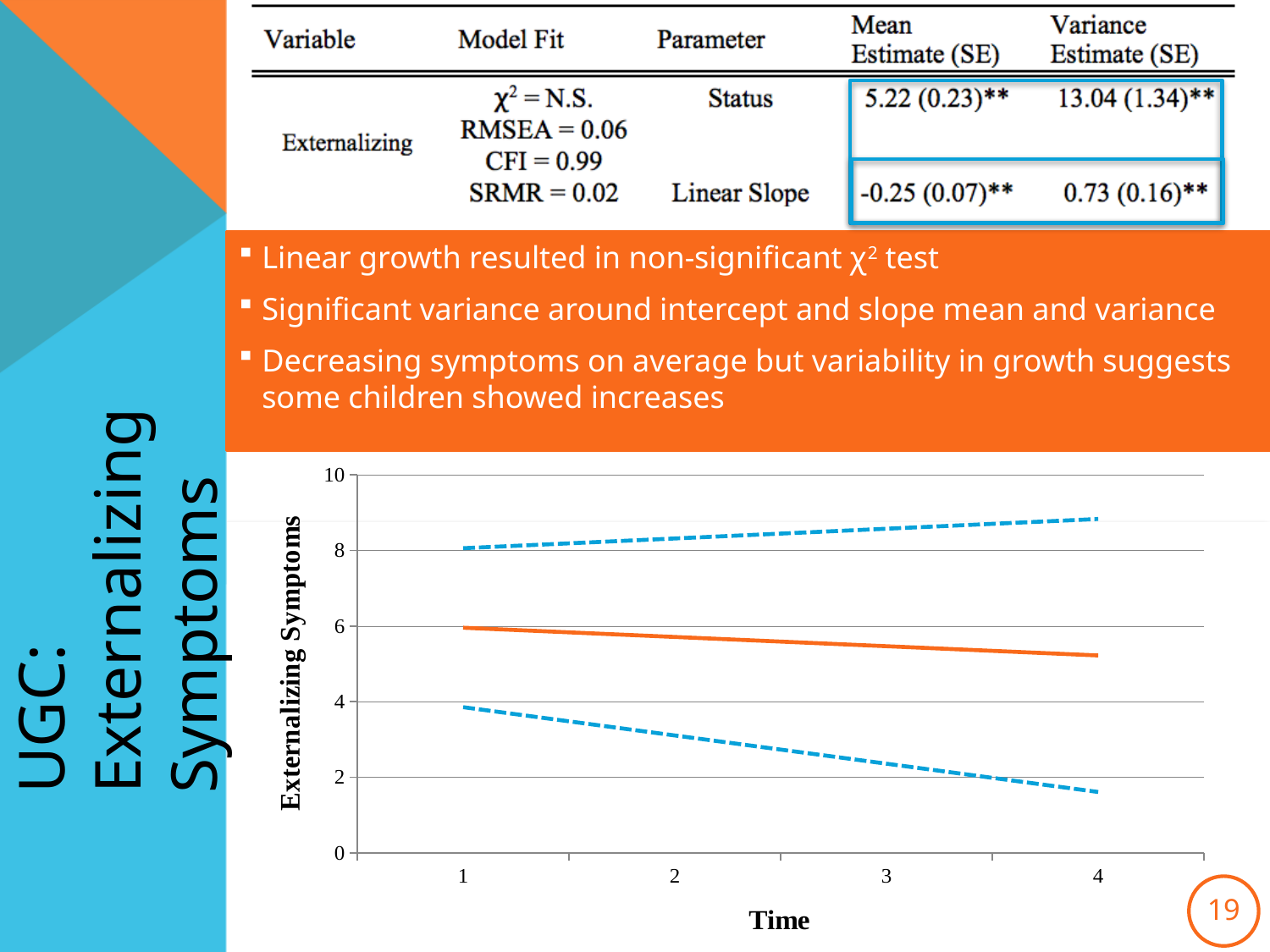
Is the value of the solid orange line at Time 4 greater or less than 6? less How many lines are plotted on the chart? 3 Is the value of the lower dashed blue line at Time 4 greater or less than 2? less Does the upper dashed blue line rise or fall from Time 1 to Time 4? rise How many time points are shown on the x axis of the chart? 4 Is the value of the upper dashed blue line at Time 4 greater or less than 8? greater What is the label of the x axis of the chart? Time Does the lower dashed blue line rise or fall from Time 1 to Time 4? fall What is the label of the y axis of the chart? Externalizing Symptoms What kind of chart is shown at the bottom of the slide? line chart Does the solid orange line rise or fall from Time 1 to Time 4? fall